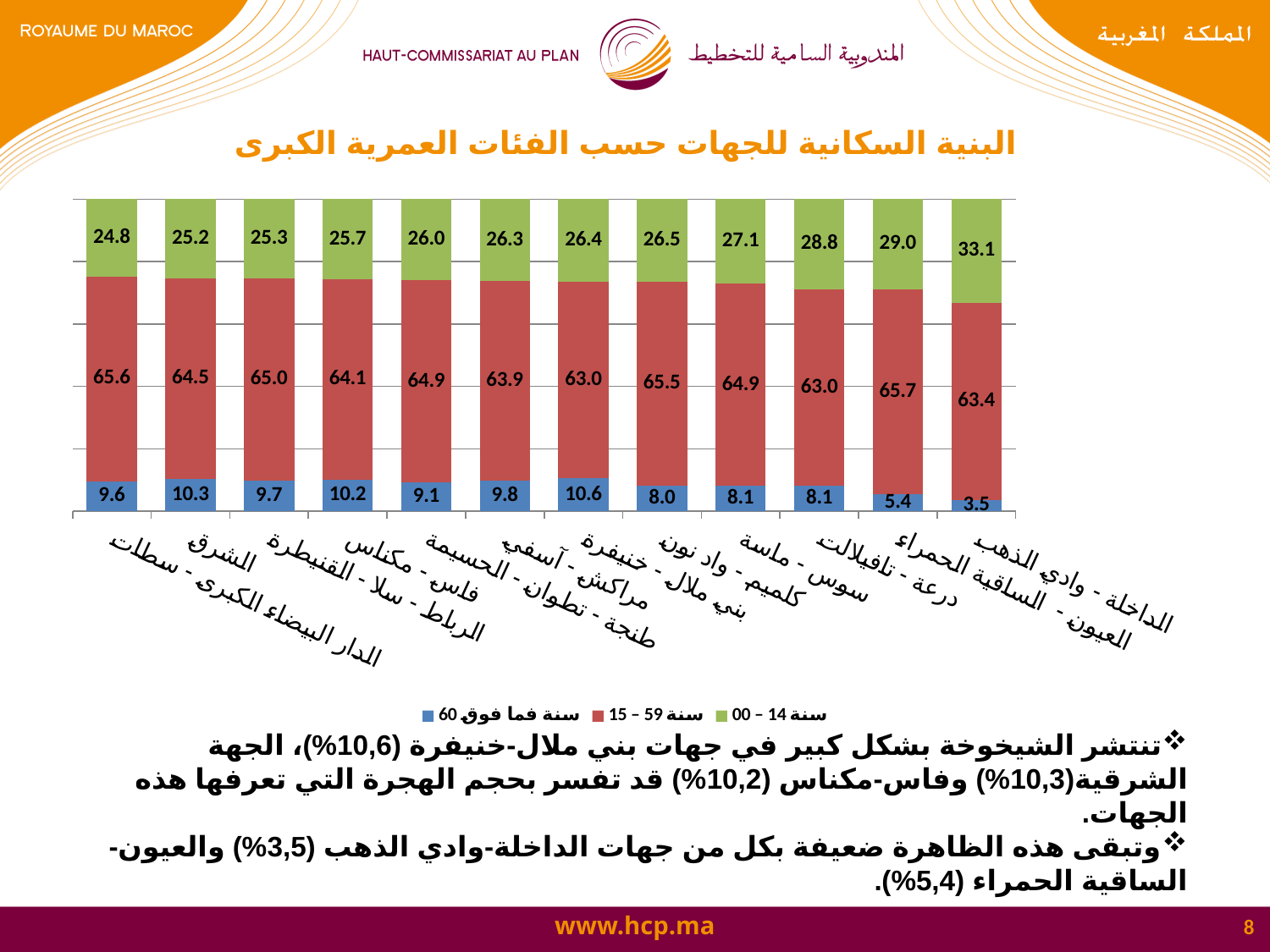
What is the value of the 60 years and over (60 سنة فما فوق) series for الداخلة - وادي الذهب? 3.5 Which region has the lowest value for the 60 years and over (60 سنة فما فوق) series? الداخلة - وادي الذهب What is the value of the 15-59 years (15 - 59 سنة) series for العيون - الساقية الحمراء? 65.7 How many regions are shown on the x axis of the chart? 12 What is the difference between the 0-14 years values of الداخلة - وادي الذهب and الدار البيضاء - سطات? 8.3 Which region has the highest value for the 60 years and over (60 سنة فما فوق) series? بني ملال - خنيفرة Which is larger: the 60 years and over value for الشرق or for فاس - مكناس? الشرق What is the total of the stacked bar for سوس - ماسة? 100.1 What kind of chart is shown on the slide? Stacked bar chart What is the value of the 0-14 years (00 - 14 سنة) series for الشرق? 25.2 Which region has the highest value for the 0-14 years (00 - 14 سنة) series? الداخلة - وادي الذهب How many series does the legend list? 3